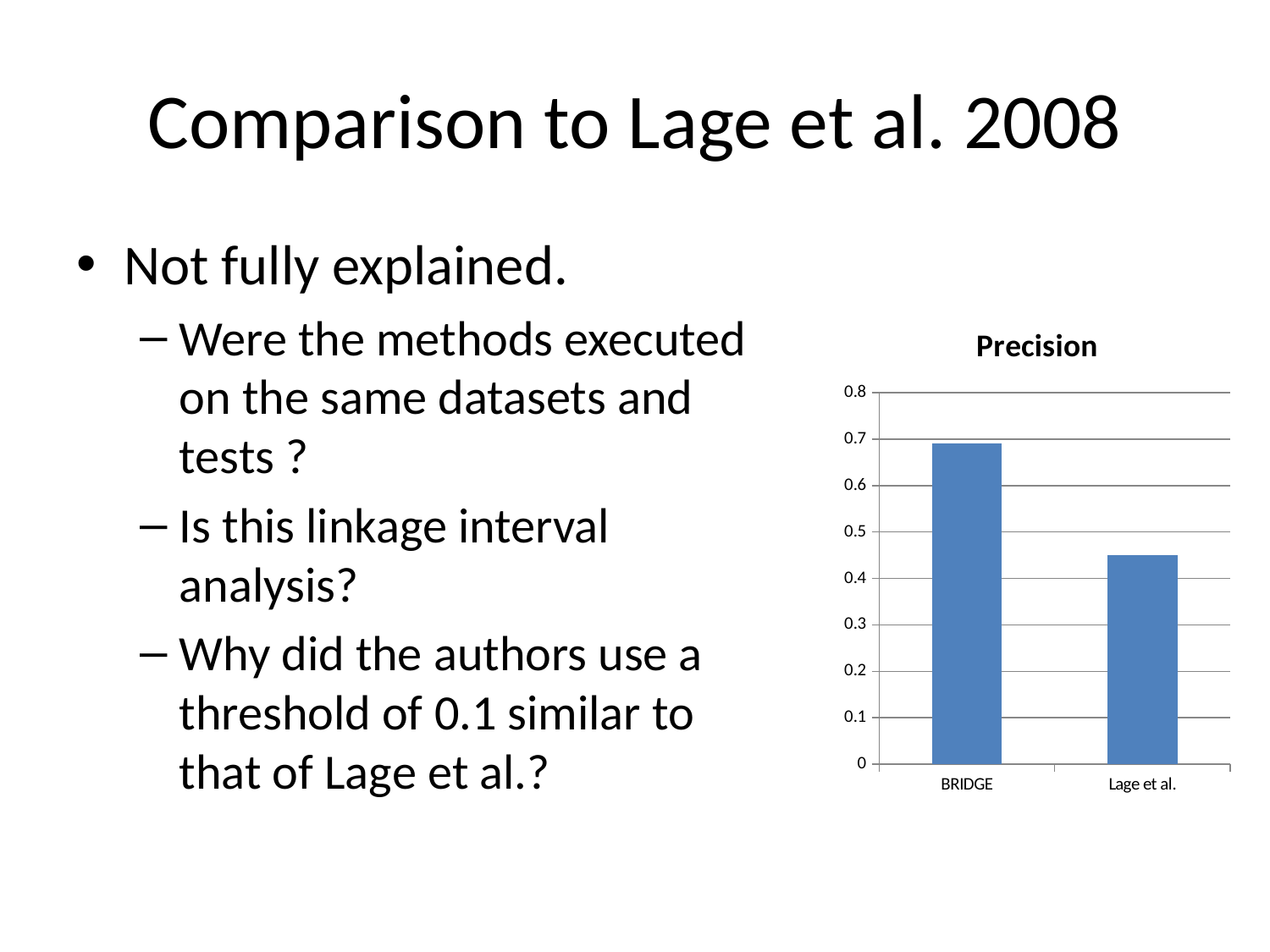
Do the bar values rise or fall moving from BRIDGE to Lage et al. along the x axis? fall What kind of chart is shown on the slide? bar chart Which has the larger precision value, BRIDGE or Lage et al.? BRIDGE Which category has the highest precision? BRIDGE Is the precision value for BRIDGE greater or less than 0.6? greater Is the precision value for Lage et al. greater or less than 0.5? less Is the precision value for Lage et al. greater or less than 0.4? greater How many categories are plotted in the Precision chart? 2 What is the title of the chart? Precision What is the highest value shown on the vertical axis of the chart? 0.8 Which category has the lowest precision? Lage et al.